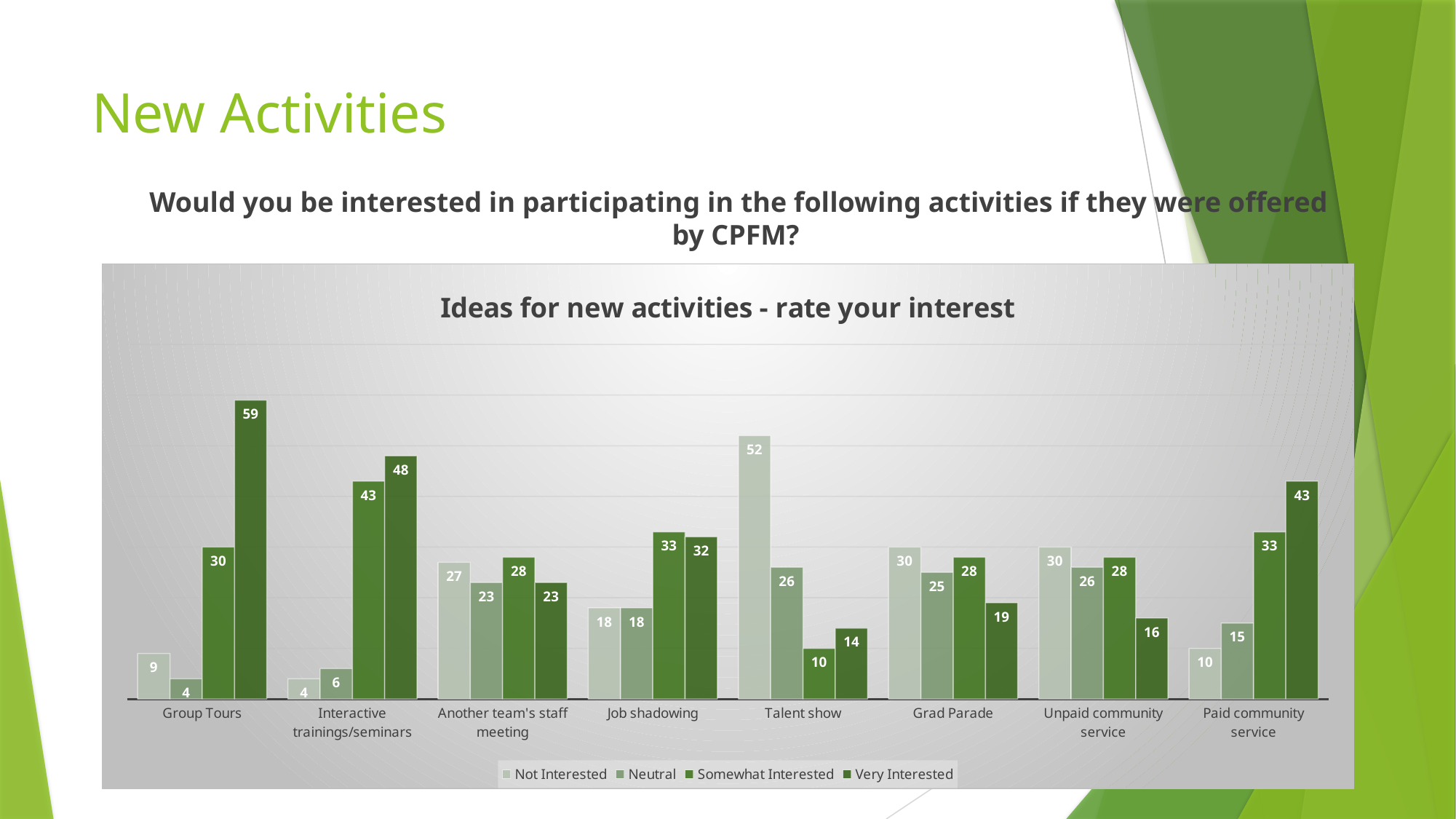
What kind of chart is shown? Bar chart What is the Neutral value for Paid community service? 15 Which is larger for Talent show: the Not Interested value or the Very Interested value? Not Interested How many series does the legend list? 4 What is the difference between the Very Interested and Not Interested values for Paid community service? 33 How many activities are shown on the x axis? 8 What is the Not Interested value for Talent show? 52 What is the title of the chart? Ideas for new activities - rate your interest Which activity has the lowest Not Interested value? Interactive trainings/seminars What is the Somewhat Interested value for Job shadowing? 33 Which activity has the highest Very Interested value? Group Tours What is the Very Interested value for Group Tours? 59